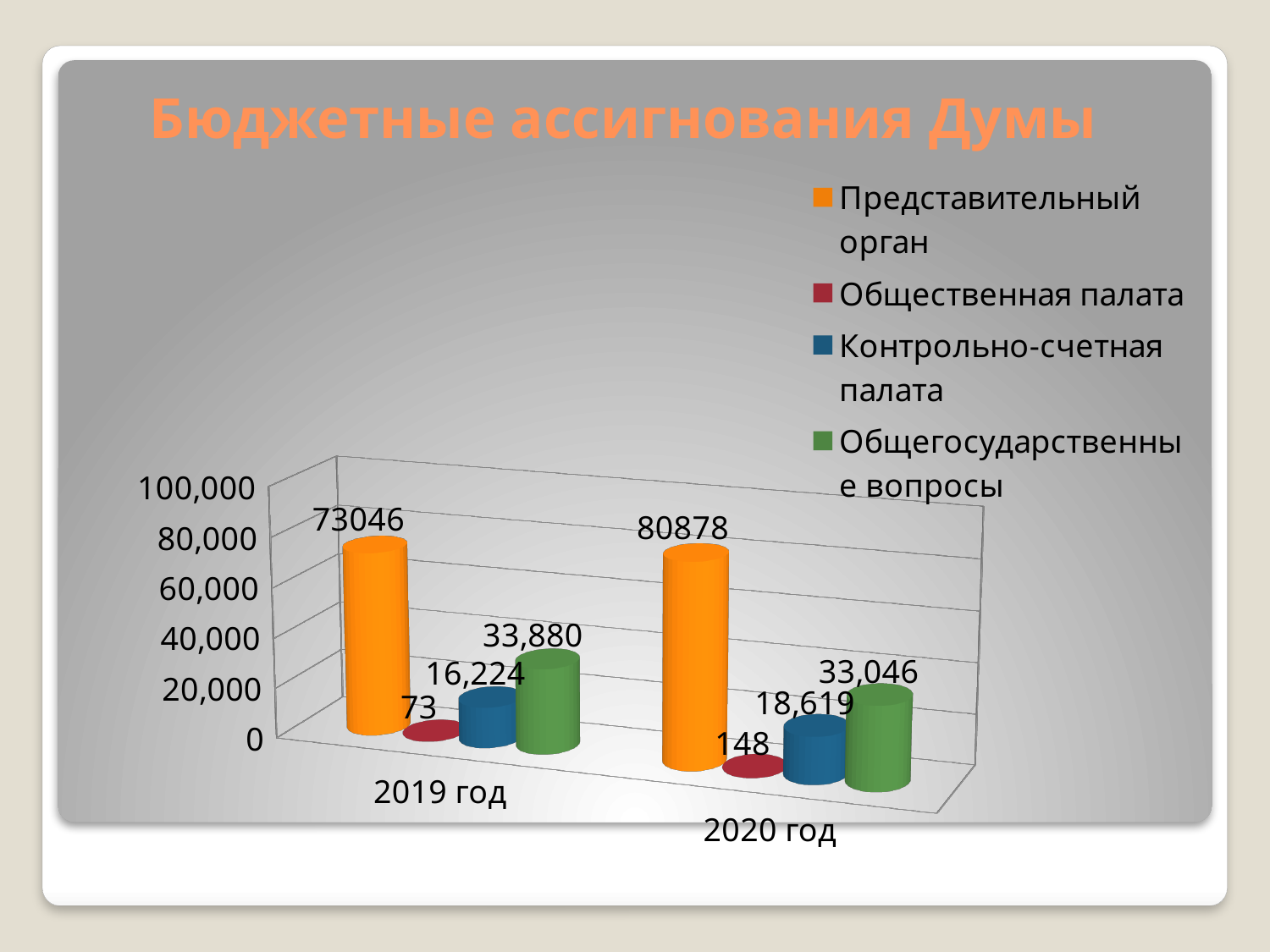
What is the value for Общественная палата in 2019 год? 73 What is the value for Общегосударственные вопросы in 2019 год? 33,880 What is the value for Представительный орган in 2020 год? 80878 How many categories are shown on the x axis? 2 How many series does the legend list? 4 What is the value for Контрольно-счетная палата in 2020 год? 18,619 Is the value for Общегосударственные вопросы in 2020 год larger or smaller than in 2019 год? smaller What is the value for Представительный орган in 2019 год? 73046 What is the difference between the Представительный орган values for 2020 год and 2019 год? 7832 Which series has the lowest value in 2019 год? Общественная палата Which series has the highest value in 2020 год? Представительный орган What is the title of the chart? Бюджетные ассигнования Думы